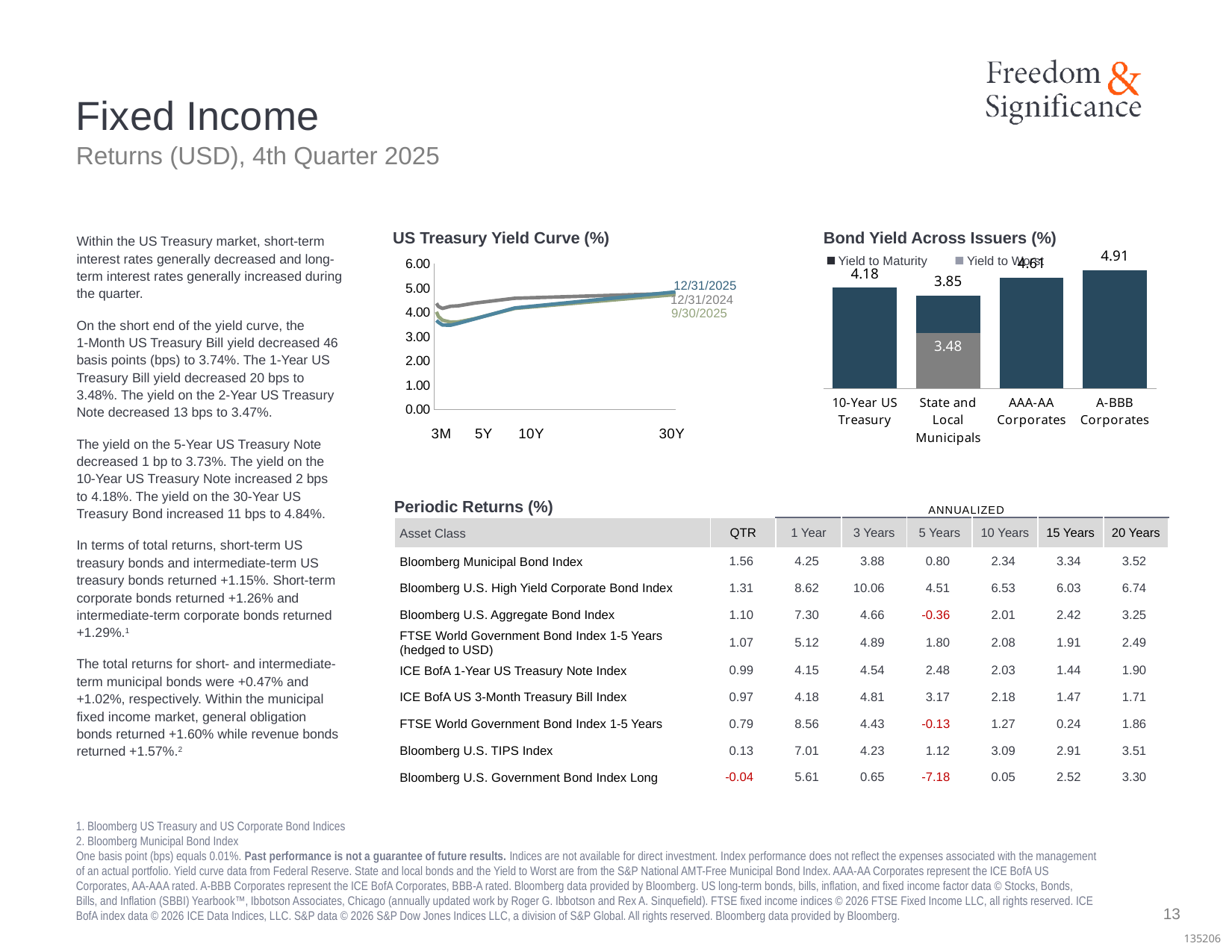
In the Bond Yield Across Issuers (%) chart, which issuer has the highest Yield to Maturity? A-BBB Corporates In the Bond Yield Across Issuers (%) chart, what is the Yield to Maturity for A-BBB Corporates? 4.91 In the Bond Yield Across Issuers (%) chart, which issuer has the lowest Yield to Maturity? State and Local Municipals In the US Treasury Yield Curve (%) chart, how many dated series does the chart show? 3 In the Bond Yield Across Issuers (%) chart, what is the Yield to Worst for State and Local Municipals? 3.48 In the US Treasury Yield Curve (%) chart, is the 12/31/2025 value at 30Y greater or less than 4.00? greater What type of chart is the US Treasury Yield Curve (%) chart? Line chart How many series does the legend of the Bond Yield Across Issuers (%) chart list? 2 How many issuer categories are shown in the Bond Yield Across Issuers (%) chart? 4 In the Bond Yield Across Issuers (%) chart, what is the difference between the Yield to Maturity of A-BBB Corporates and the 10-Year US Treasury? 0.73 In the Bond Yield Across Issuers (%) chart, what is the Yield to Maturity for the 10-Year US Treasury? 4.18 In the Bond Yield Across Issuers (%) chart, which is larger: the Yield to Maturity for AAA-AA Corporates or for the 10-Year US Treasury? AAA-AA Corporates